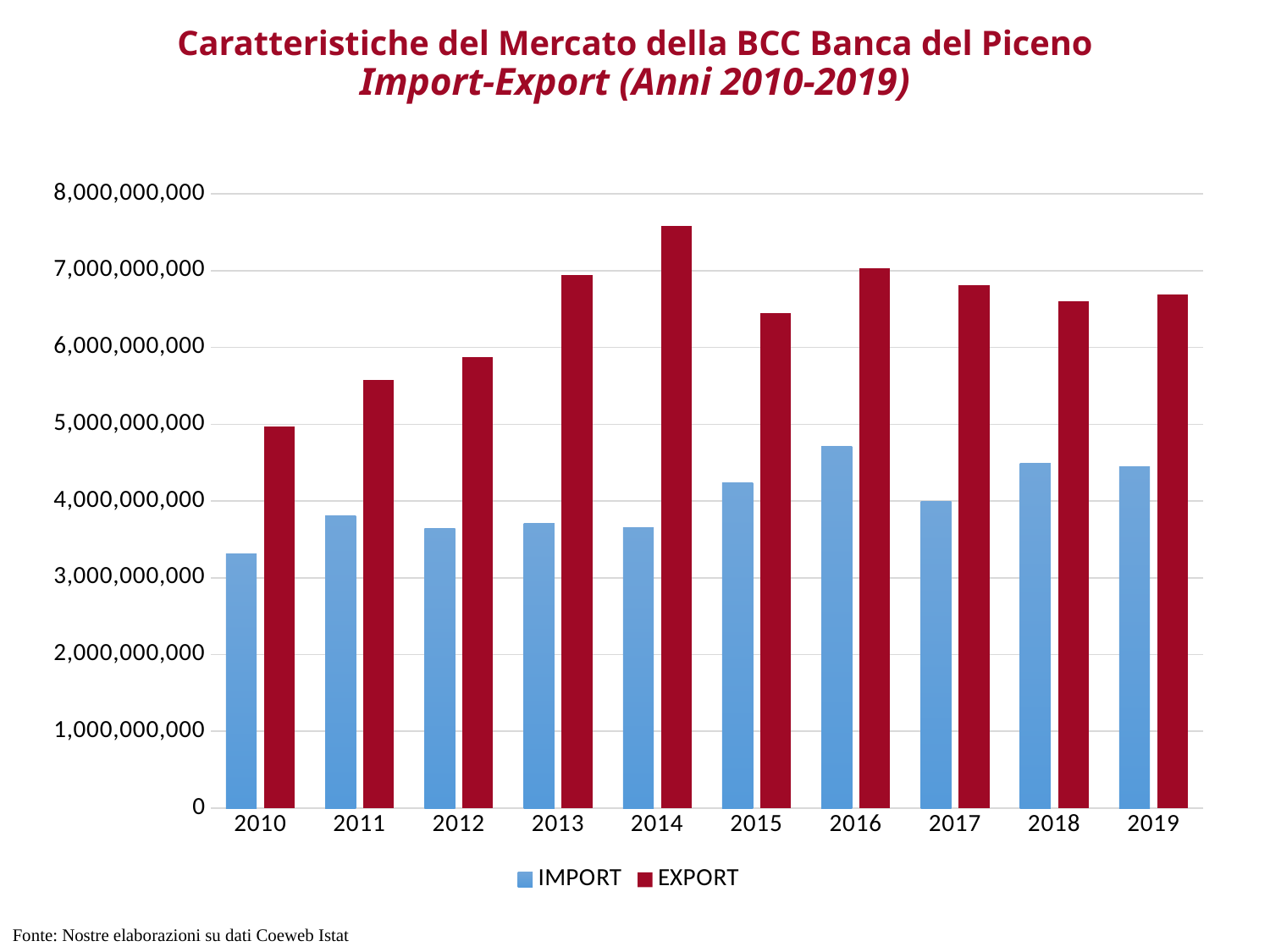
In which year is the EXPORT value lowest? 2010 How many series does the legend list? 2 Which is larger in 2015, IMPORT or EXPORT? EXPORT Is the EXPORT value for 2014 greater or less than 7,000,000,000? greater In which year is the EXPORT value highest? 2014 How many years are shown on the x axis? 10 Is the EXPORT value for 2012 greater or less than 6,000,000,000? less Which series is drawn in dark red bars? EXPORT In which year is the IMPORT value lowest? 2010 What kind of chart is shown on the slide? Bar chart Do the EXPORT values rise or fall from 2010 to 2014? rise Is the IMPORT value for 2016 greater or less than 4,000,000,000? greater